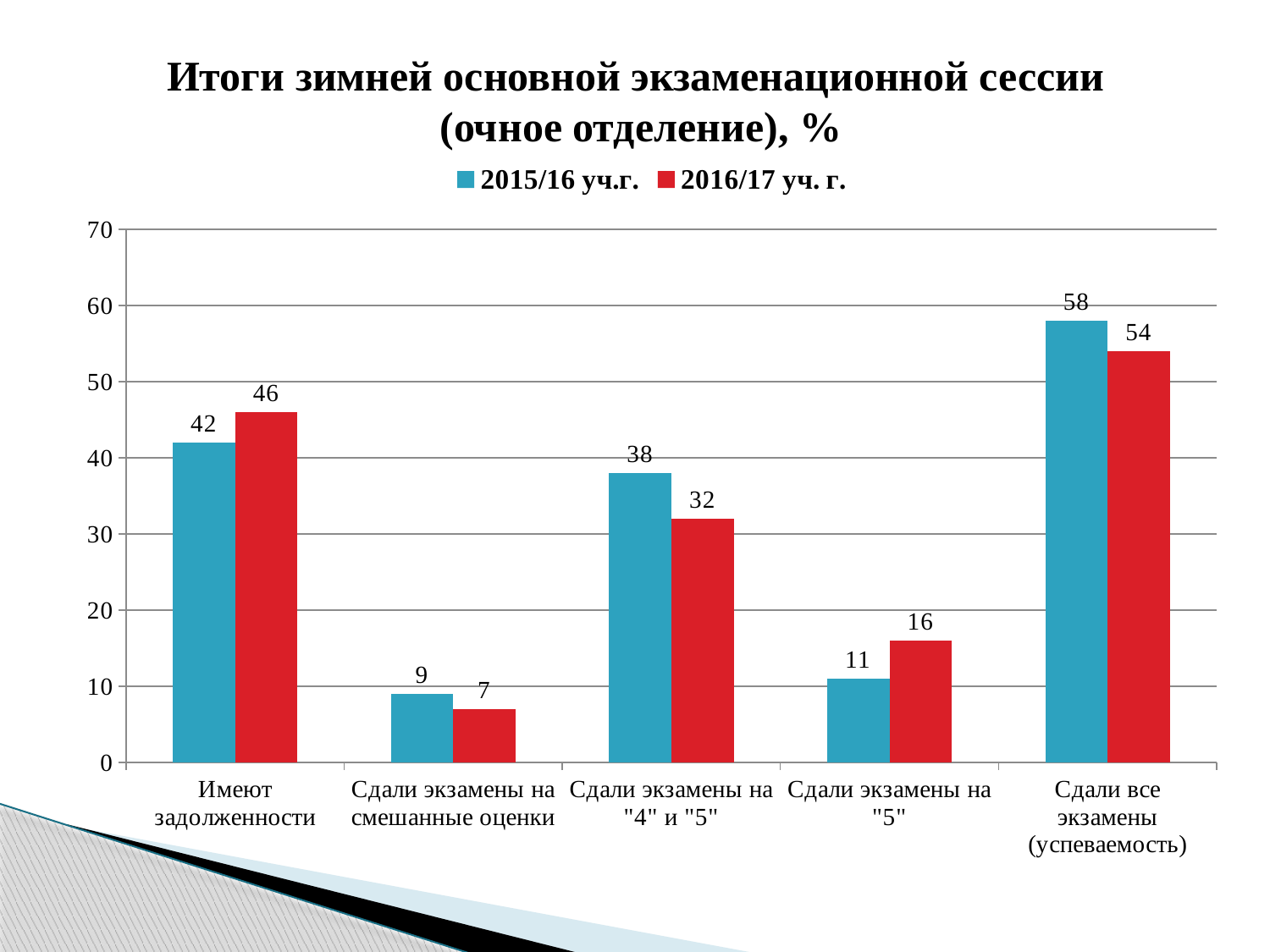
Is the 2015/16 уч.г. value for "Сдали все экзамены (успеваемость)" greater or less than 50? greater What is the value for 2015/16 уч.г. in the category "Имеют задолженности"? 42 What kind of chart is shown on the slide? bar chart Which is larger for "Имеют задолженности": the 2015/16 уч.г. value or the 2016/17 уч. г. value? 2016/17 уч. г. What is the value for 2016/17 уч. г. in the category "Сдали экзамены на "5""? 16 How many series does the legend list? 2 Which colour represents 2016/17 уч. г. in the chart? red How many categories are shown on the x axis? 5 What is the difference between the 2015/16 уч.г. and 2016/17 уч. г. values for "Сдали экзамены на "4" и "5""? 6 Which category has the lowest value for 2016/17 уч. г.? Сдали экзамены на смешанные оценки What is the value for 2016/17 уч. г. in the category "Сдали все экзамены (успеваемость)"? 54 Which category has the highest value for 2015/16 уч.г.? Сдали все экзамены (успеваемость)